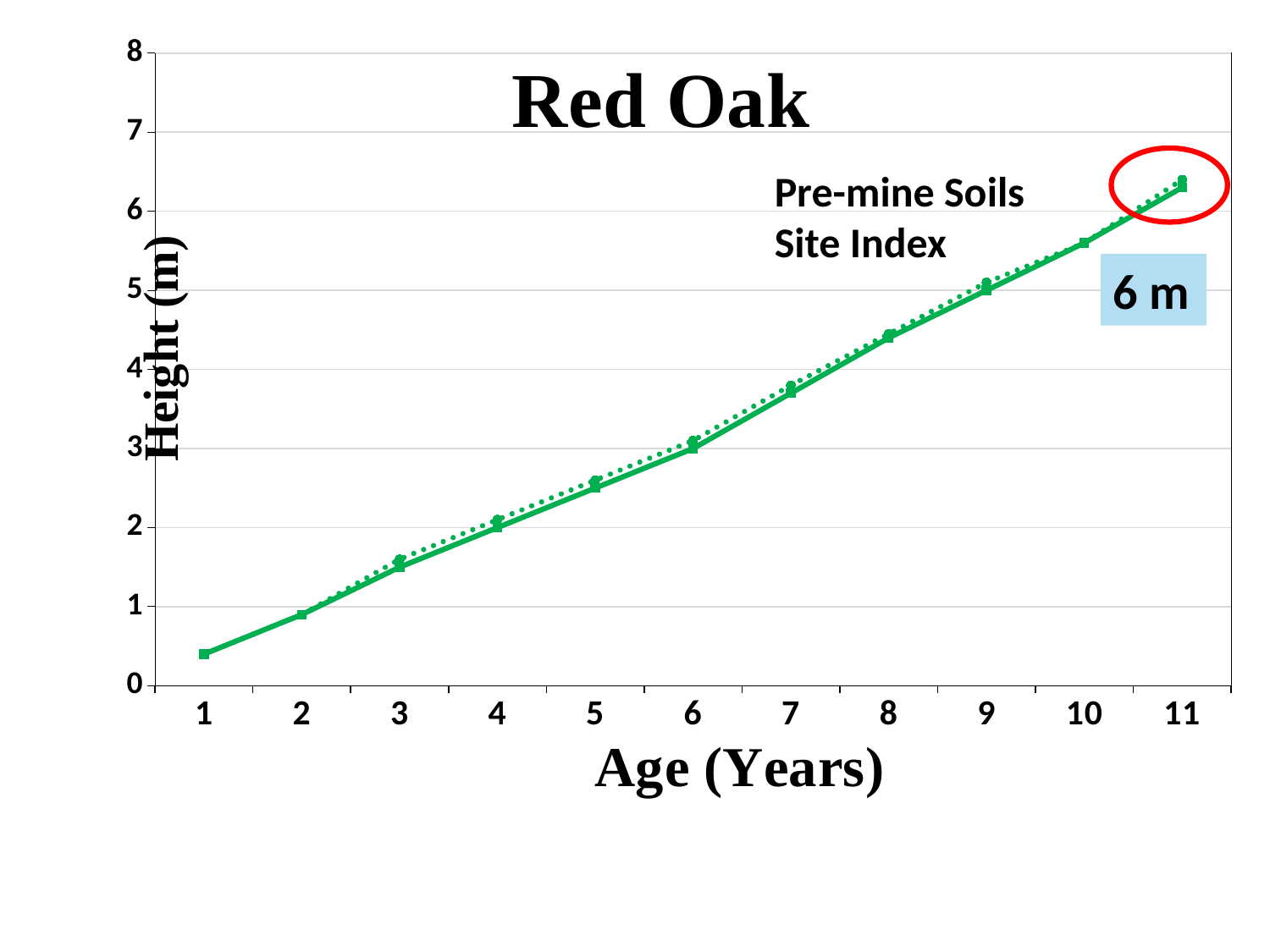
How many age points are plotted along the x axis? 11 What kind of chart is shown on the slide? line chart Is the height at age 7 greater or less than 4? less Is the height at age 10 greater or less than 5? greater Is the height at age 8 greater or less than 4? greater At which age is the height lowest? 1 What is the title of the chart? Red Oak Does the height rise or fall as age increases along the x axis? rise At which age is the height highest? 11 What is the label of the y axis? Height (m)